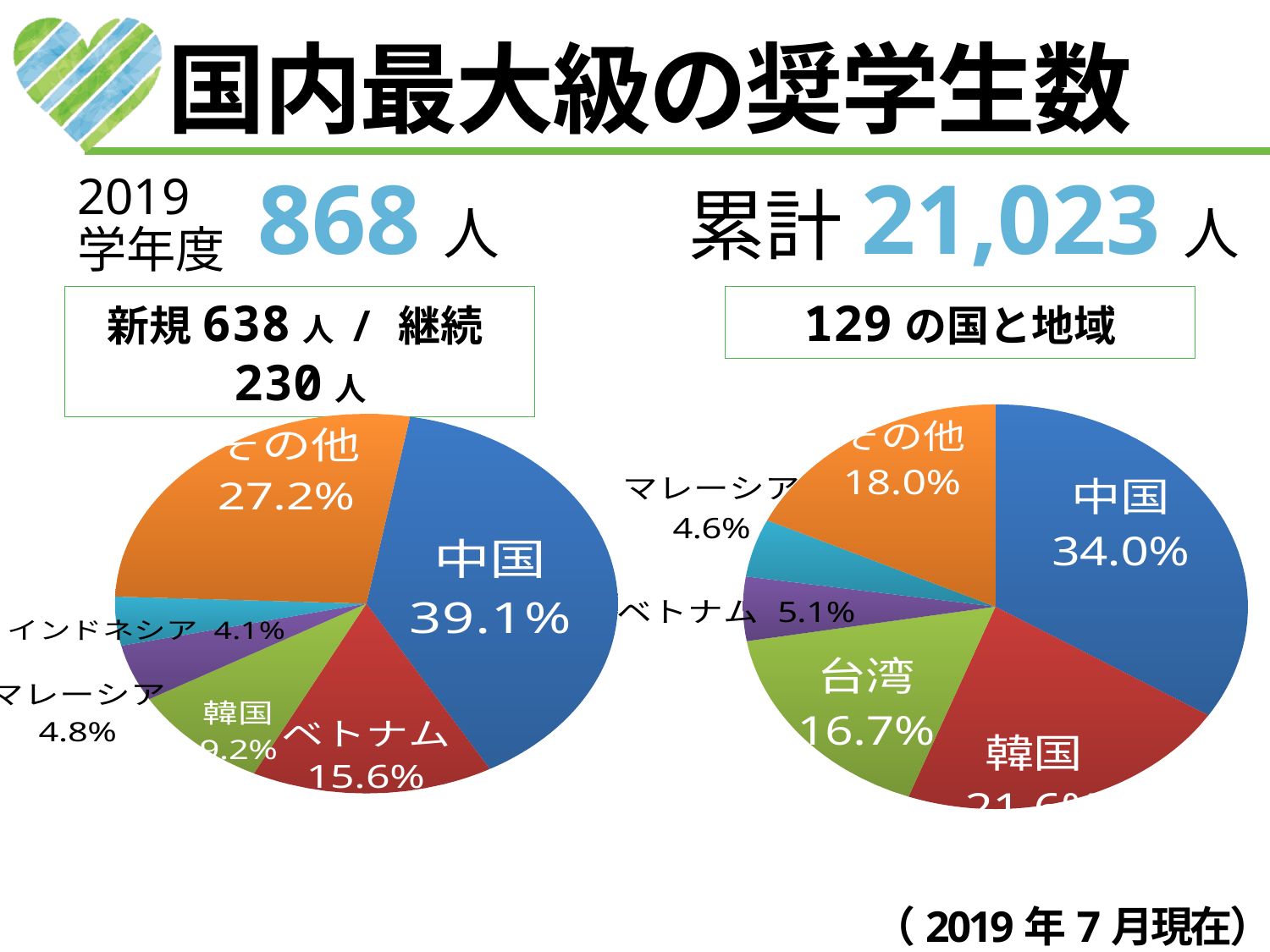
In the right pie chart, what share is shown for 台湾? 16.7% In the left pie chart, which category has the largest share? 中国 In the left pie chart, what share is shown for インドネシア? 4.1% In the left pie chart, what share is shown for ベトナム? 15.6% In the right pie chart, what share is shown for マレーシア? 4.6% In the right pie chart, which is larger, the share of 台湾 or the share of その他? その他 In the left pie chart, what share is shown for 中国? 39.1% In the left pie chart, which category has the smallest share? インドネシア In the right pie chart, what share is shown for 中国? 34.0% In the left pie chart, what is the difference between the shares of 中国 and ベトナム? 23.5% In the left pie chart, what share is shown for その他? 27.2% What kind of chart is used on the left side of the slide? Pie chart